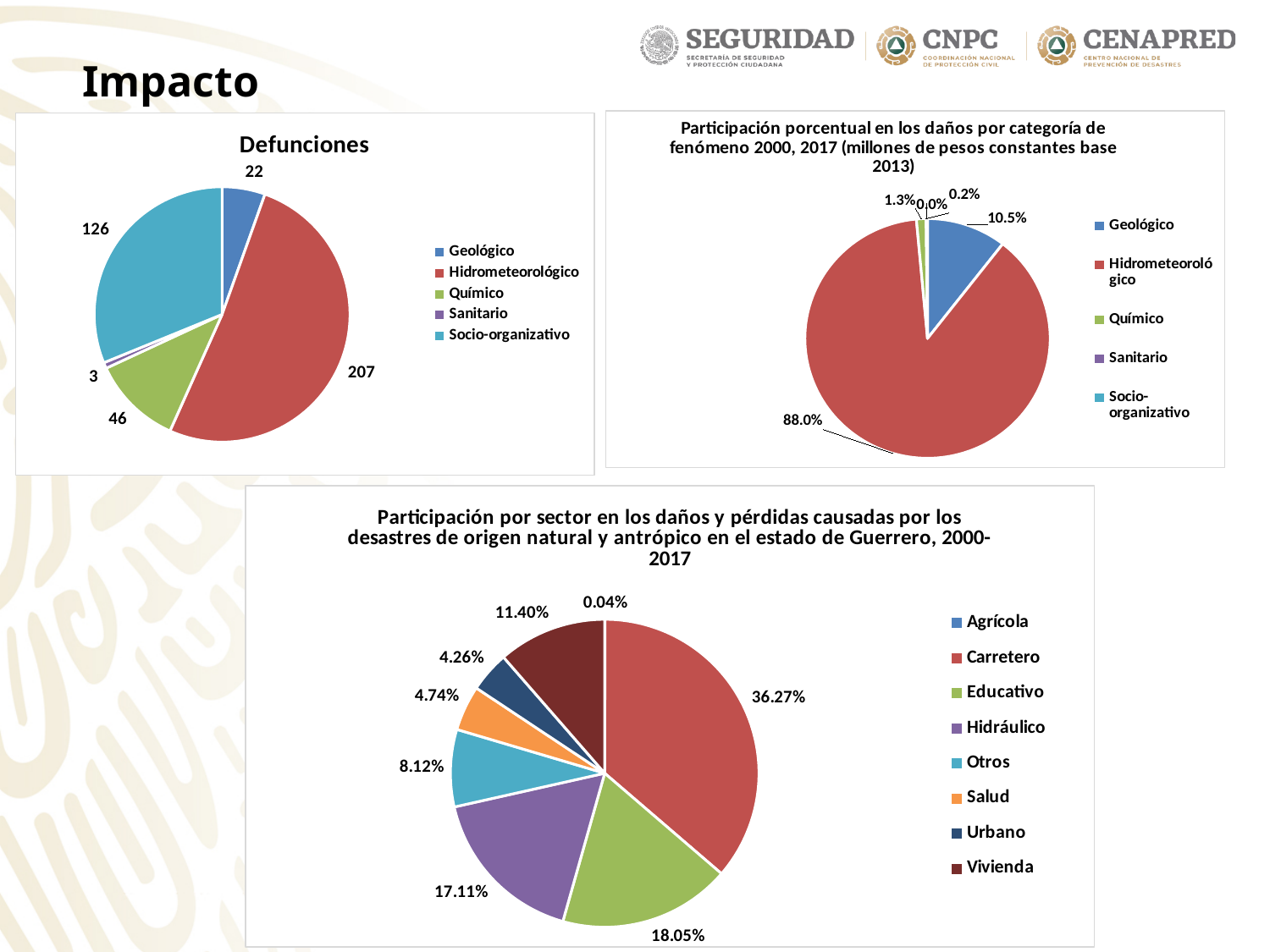
In the Defunciones chart, which category has the fewest deaths? Sanitario In the chart titled 'Participación porcentual en los daños por categoría de fenómeno 2000, 2017', what share does Hidrometeorológico have? 88.0% In the chart titled 'Participación porcentual en los daños por categoría de fenómeno 2000, 2017', which category has the largest share? Hidrometeorológico In the bottom chart on sector participation in Guerrero, what share does Carretero have? 36.27% What type of chart is the bottom chart on sector participation in Guerrero? Pie chart In the bottom chart on sector participation in Guerrero, which is larger, Educativo or Hidráulico? Educativo In the Defunciones chart, how many deaths are attributed to Hidrometeorológico? 207 In the bottom chart on sector participation in Guerrero, which sector has the smallest share? Agrícola In the Defunciones chart, what is the difference between the Químico and Geológico values? 24 In the Defunciones chart, how many deaths are attributed to Socio-organizativo? 126 In the Defunciones chart, how many categories does the legend list? 5 In the chart titled 'Participación porcentual en los daños por categoría de fenómeno 2000, 2017', what share does Geológico have? 10.5%